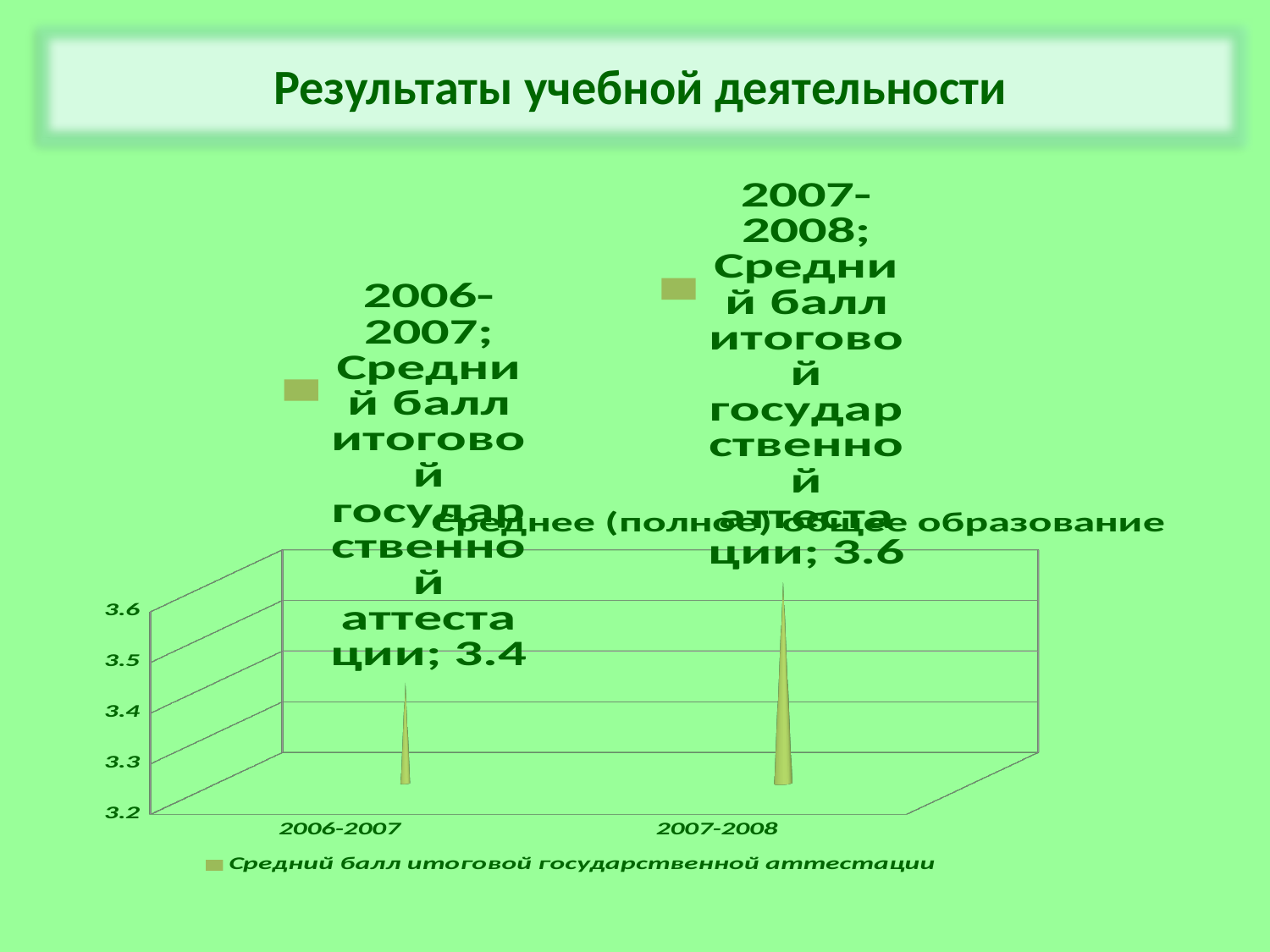
Do the values rise or fall from 2006-2007 to 2007-2008? rise How many series does the legend list? 1 What is the value for 2007-2008? 3.6 Is the value for 2006-2007 greater or less than 3.5? less What is the title of the chart? Среднее (полное) общее образование Which is larger, the value for 2006-2007 or the value for 2007-2008? 2007-2008 What is the difference between the values for 2007-2008 and 2006-2007? 0.2 How many categories are shown on the x axis? 2 What is the value for 2006-2007? 3.4 What kind of chart is shown on the slide? bar chart Which category has the lowest value? 2006-2007 Which category has the highest value? 2007-2008